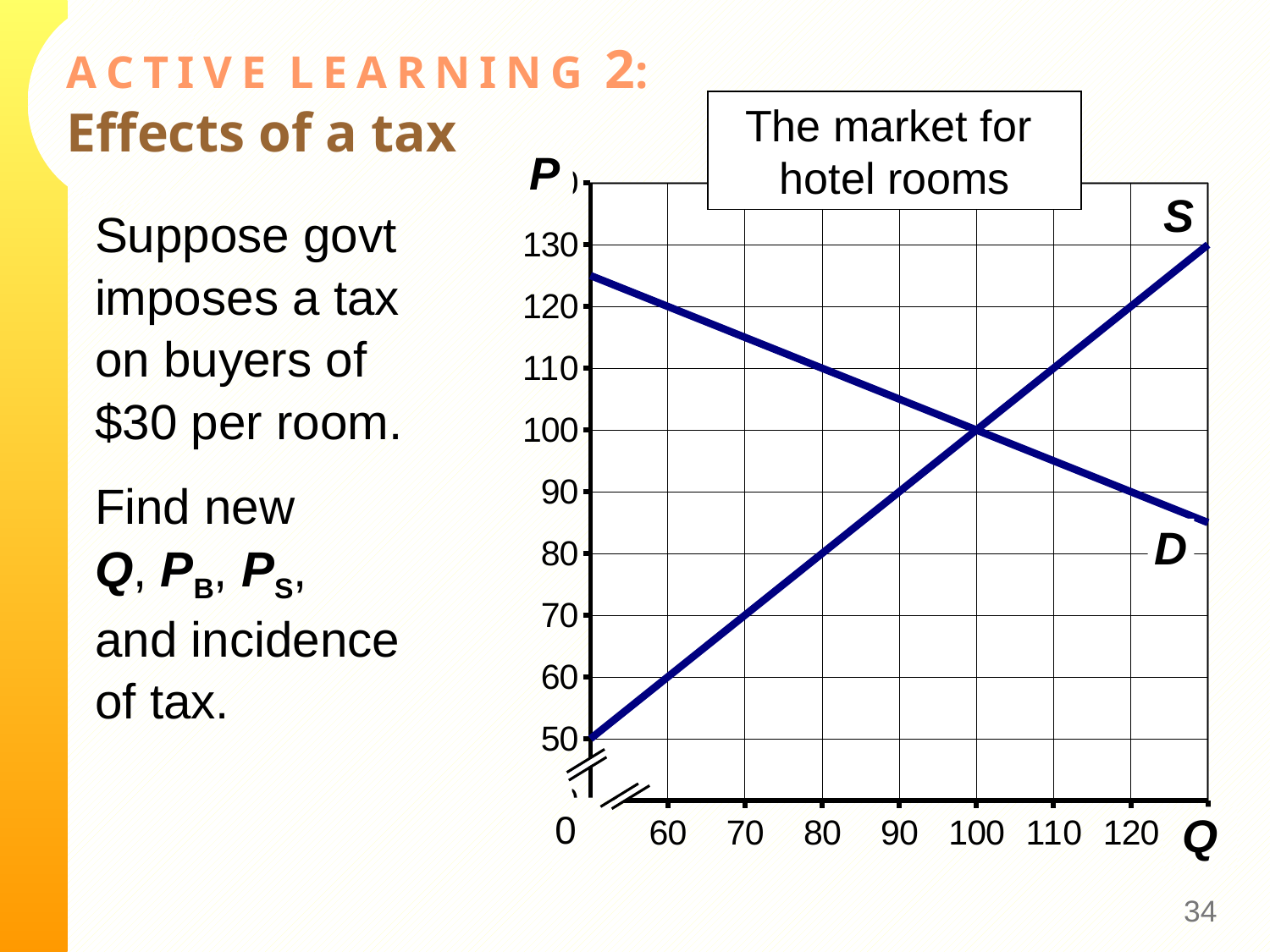
What kind of chart is shown on the slide? line chart At what price P do the S and D curves intersect? 100 What is the price on the S curve when Q is 60? 60 How many curves are plotted on the chart? 2 What is the price on the D curve when Q is 60? 120 What are the labels of the two curves on the chart? S and D At Q = 120, is the price on the D curve greater or less than 100? less What is the title of the chart? The market for hotel rooms At Q = 80, which curve has the higher price, S or D? D Does the S curve rise or fall as Q increases? rise Does the D curve rise or fall as Q increases? fall At what quantity Q do the S and D curves intersect? 100